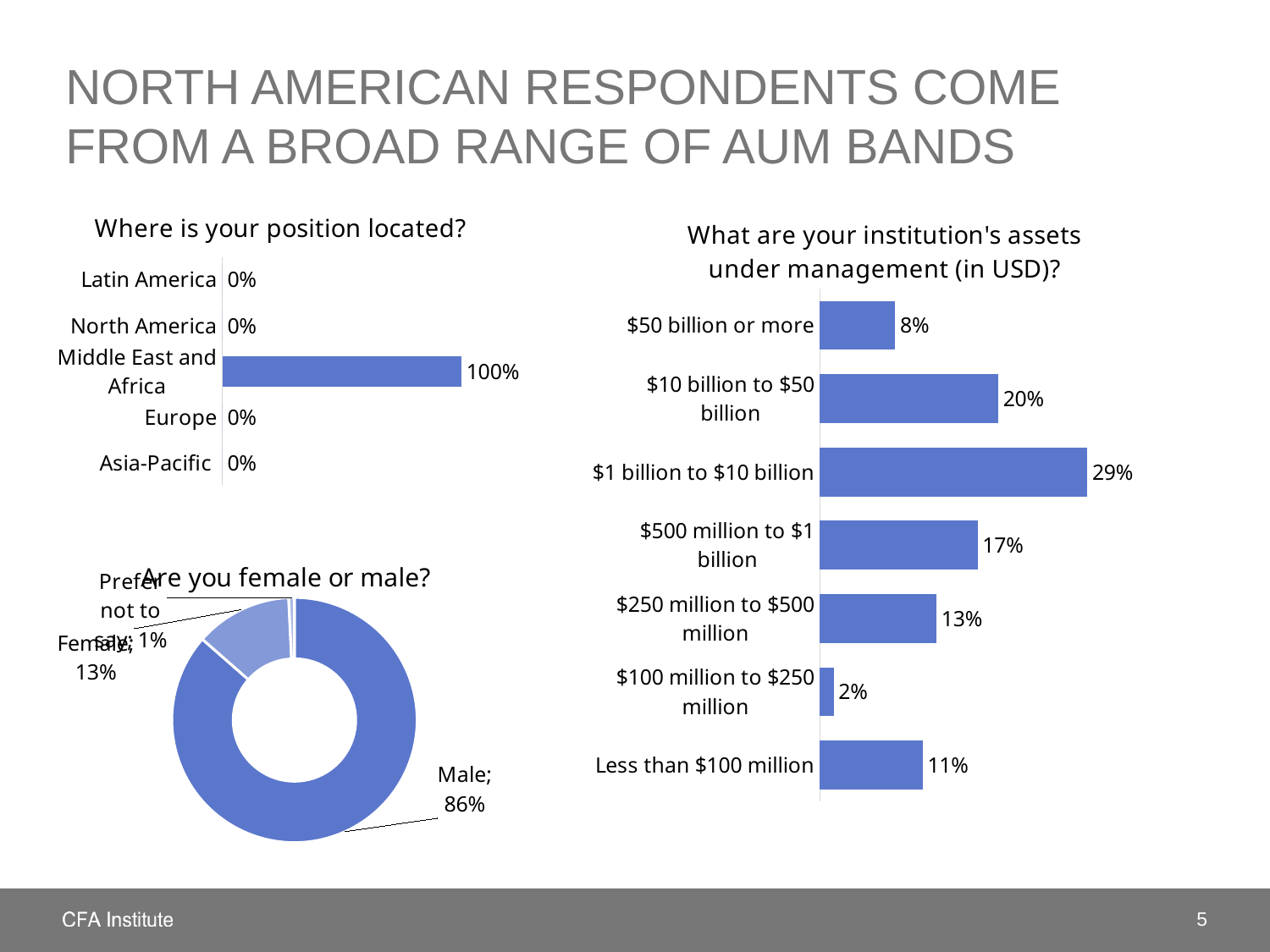
In the chart 'What are your institution's assets under management (in USD)?', what is the value for '$1 billion to $10 billion'? 29% In the chart 'What are your institution's assets under management (in USD)?', what is the value for 'Less than $100 million'? 11% How many AUM bands are shown in the chart 'What are your institution's assets under management (in USD)?'? 7 How many regions are listed in the chart 'Where is your position located?'? 5 In the chart 'Where is your position located?', what is the value for 'Middle East and Africa'? 100% In the chart 'What are your institution's assets under management (in USD)?', what is the difference between '$10 billion to $50 billion' and '$50 billion or more'? 12% In the chart 'Are you female or male?', what is the difference between the Female share and the 'Prefer not to say' share? 12% In the chart 'What are your institution's assets under management (in USD)?', which AUM band has the lowest value? $100 million to $250 million What type of chart is 'Where is your position located?'? Bar chart In the chart 'What are your institution's assets under management (in USD)?', which is larger: '$500 million to $1 billion' or '$250 million to $500 million'? $500 million to $1 billion In the chart 'Are you female or male?', what share of respondents are Male? 86% In the chart 'What are your institution's assets under management (in USD)?', which AUM band has the highest value? $1 billion to $10 billion